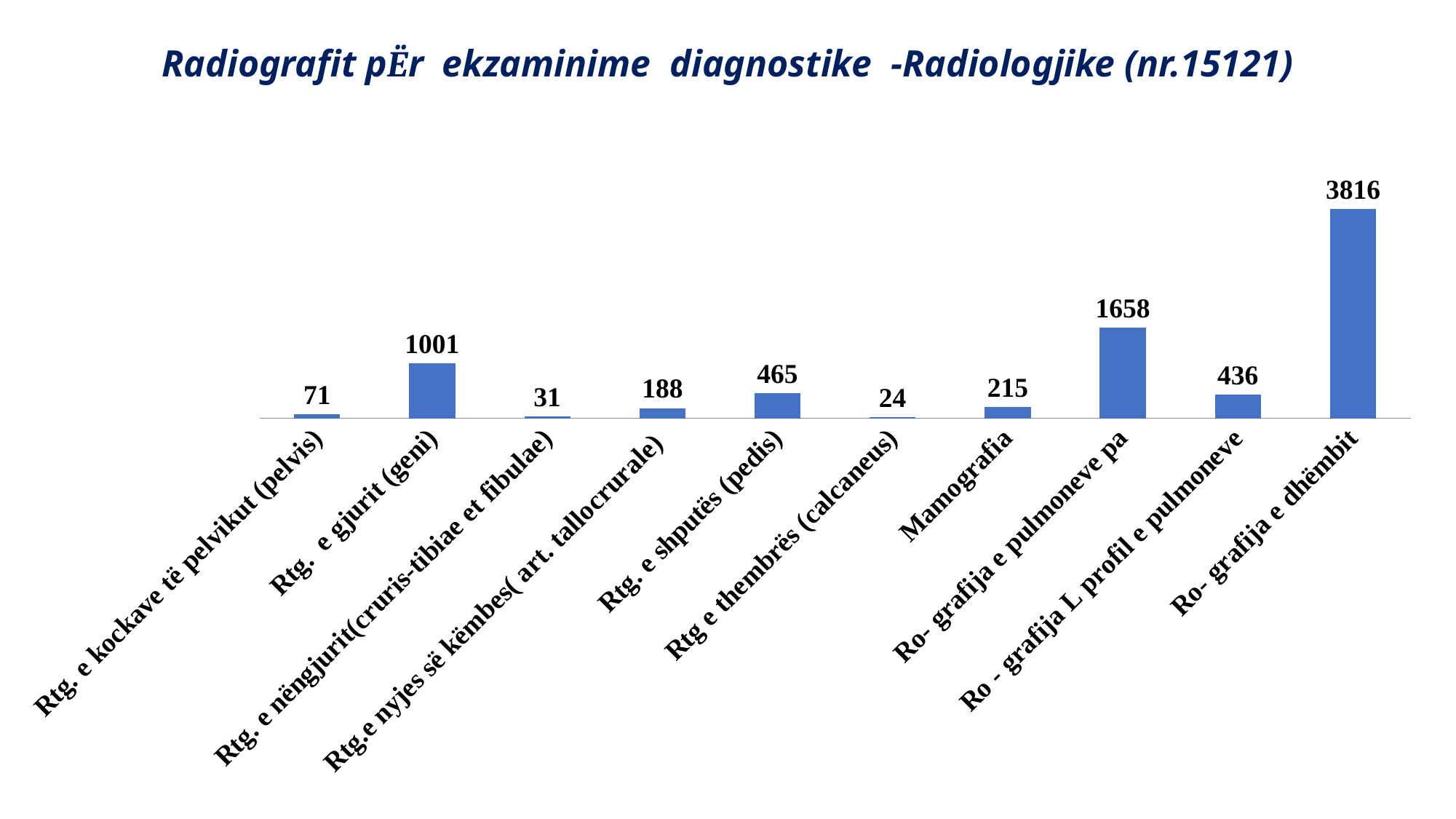
What is the value for Rtg. e gjurit (geni)? 1001 Which category has the lowest value? Rtg e thembrës (calcaneus) What is the value for Mamografia? 215 Which is larger, the value for Rtg. e kockave të pelvikut (pelvis) or the value for Rtg. e nëngjurit(cruris-tibiae et fibulae)? Rtg. e kockave të pelvikut (pelvis) What is the difference between the values for Ro- grafija e dhëmbit and Ro- grafija e pulmoneve pa? 2158 What is the title of the chart? Radiografit pËr ekzaminime diagnostike -Radiologjike (nr.15121) What kind of chart is shown on the slide? bar chart What colour are the bars in the chart? blue Which category has the highest value? Ro- grafija e dhëmbit What is the value for Ro - grafija L profil e pulmoneve? 436 How many categories are shown in the chart? 10 What is the difference between the values for Rtg. e shputës (pedis) and Rtg.e nyjes së këmbes( art. tallocrurale)? 277